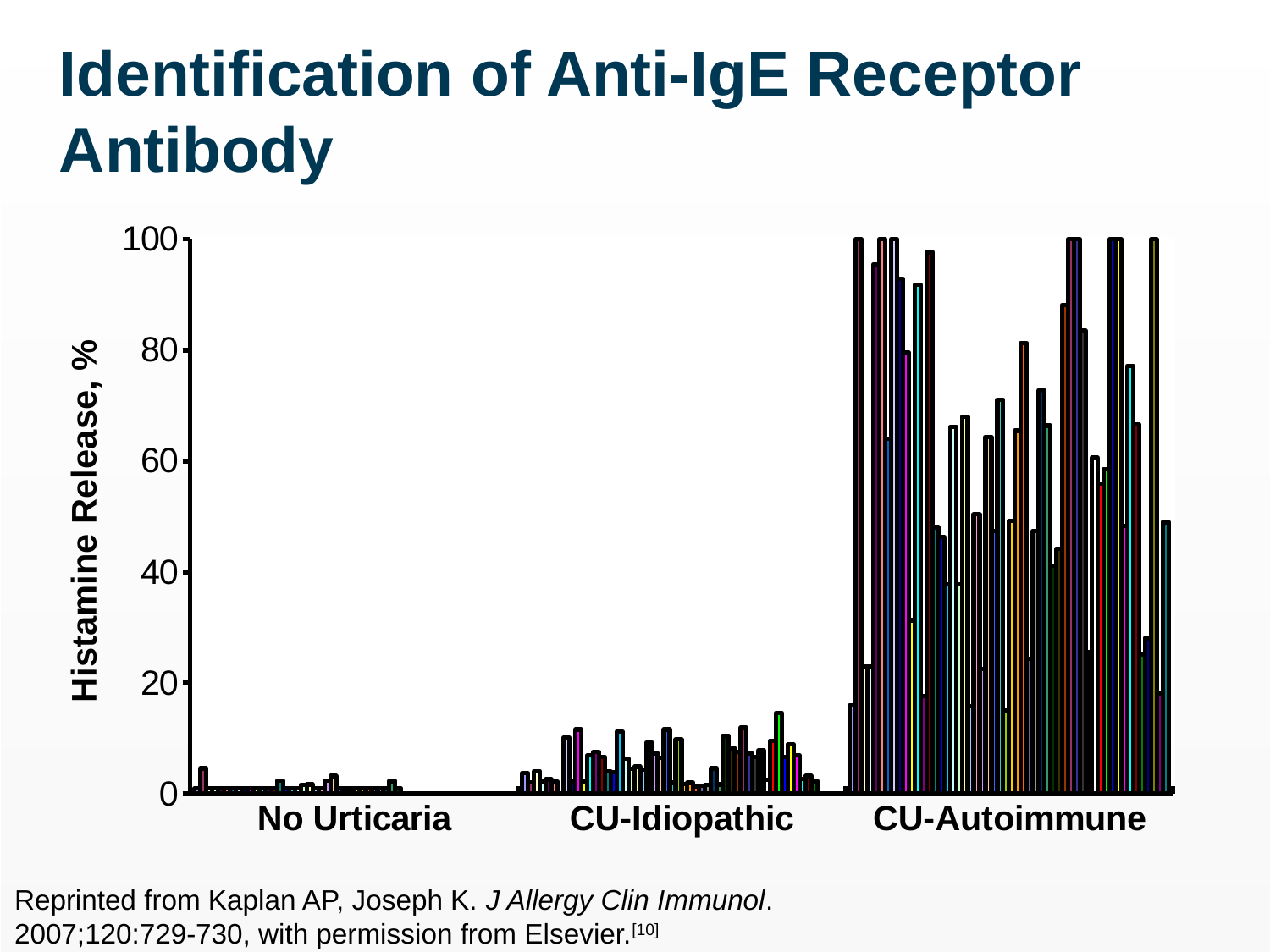
Which group on the x axis has the highest histamine release values? CU-Autoimmune What kind of chart is shown on the slide? Bar chart Are the histamine release values for the No Urticaria group greater or less than 20%? less Which group on the x axis has the lowest histamine release values? No Urticaria Do histamine release values generally rise or fall moving from No Urticaria to CU-Autoimmune along the x axis? rise What is the label of the y axis of the chart? Histamine Release, % How many patient groups are labelled along the x axis of the chart? 3 What is the maximum histamine release value reached by bars in the CU-Autoimmune group? 100 Which group has larger histamine release values, CU-Idiopathic or CU-Autoimmune? CU-Autoimmune What is the title of the slide containing the chart? Identification of Anti-IgE Receptor Antibody Is the highest histamine release value in the CU-Autoimmune group greater or less than 80%? greater Is the highest histamine release value in the CU-Idiopathic group greater or less than 20%? less